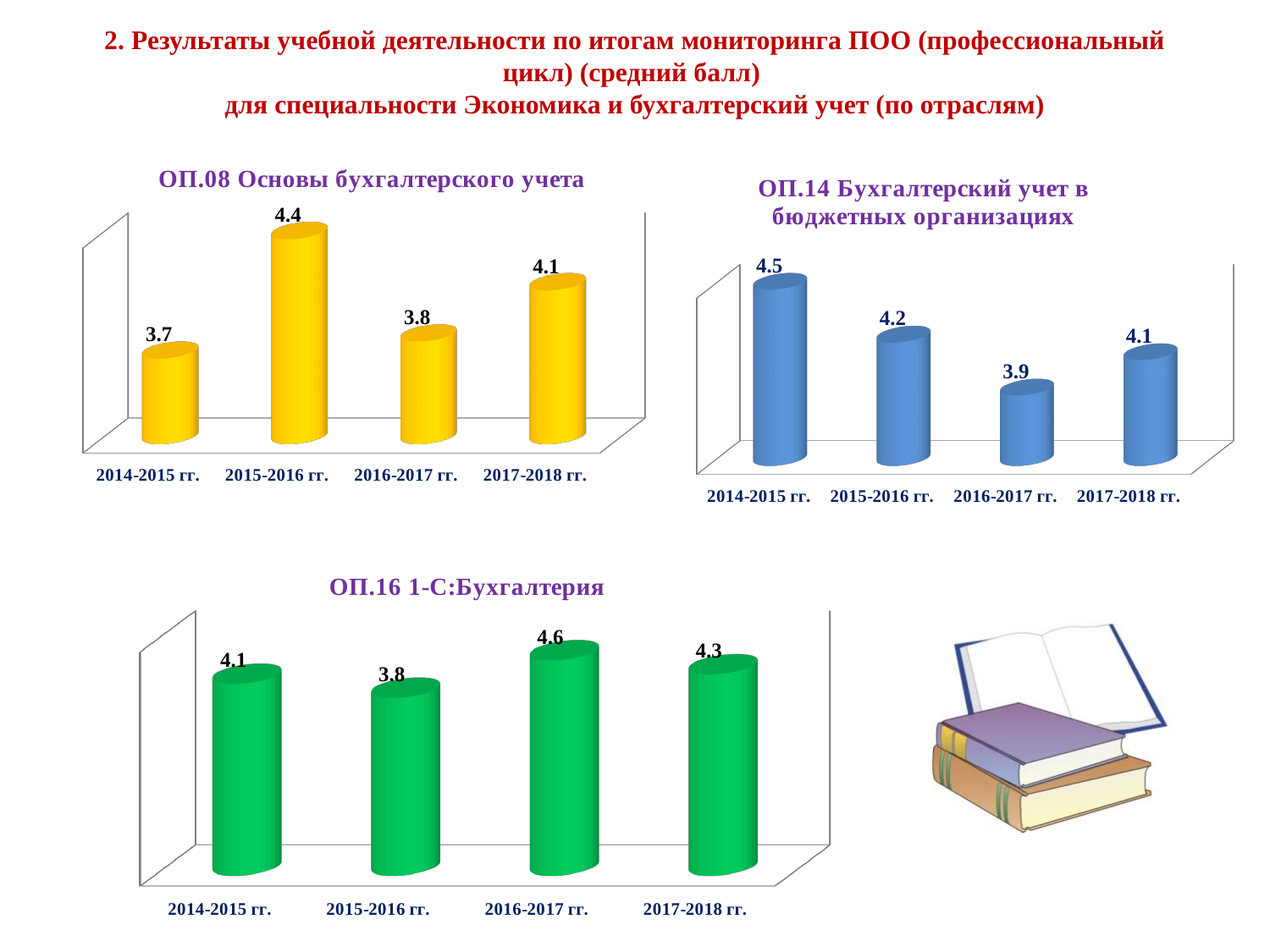
In the chart titled 'ОП.16 1-С:Бухгалтерия', what is the difference between the values for 2016-2017 гг. and 2015-2016 гг.? 0.8 In the chart titled 'ОП.08 Основы бухгалтерского учета', what is the value for 2015-2016 гг.? 4.4 In the chart titled 'ОП.08 Основы бухгалтерского учета', what is the difference between the values for 2015-2016 гг. and 2014-2015 гг.? 0.7 How many categories are shown in the chart titled 'ОП.08 Основы бухгалтерского учета'? 4 What kind of chart is the chart titled 'ОП.16 1-С:Бухгалтерия'? Bar chart In the chart titled 'ОП.14 Бухгалтерский учет в бюджетных организациях', what is the value for 2016-2017 гг.? 3.9 In the chart titled 'ОП.16 1-С:Бухгалтерия', what is the value for 2017-2018 гг.? 4.3 In the chart titled 'ОП.16 1-С:Бухгалтерия', which year has the highest value? 2016-2017 гг. In the chart titled 'ОП.14 Бухгалтерский учет в бюджетных организациях', which is larger: the value for 2015-2016 гг. or 2017-2018 гг.? 2015-2016 гг. In the chart titled 'ОП.08 Основы бухгалтерского учета', which year has the lowest value? 2014-2015 гг. In the chart titled 'ОП.14 Бухгалтерский учет в бюджетных организациях', which year has the highest value? 2014-2015 гг. What colour are the bars in the chart titled 'ОП.14 Бухгалтерский учет в бюджетных организациях'? Blue